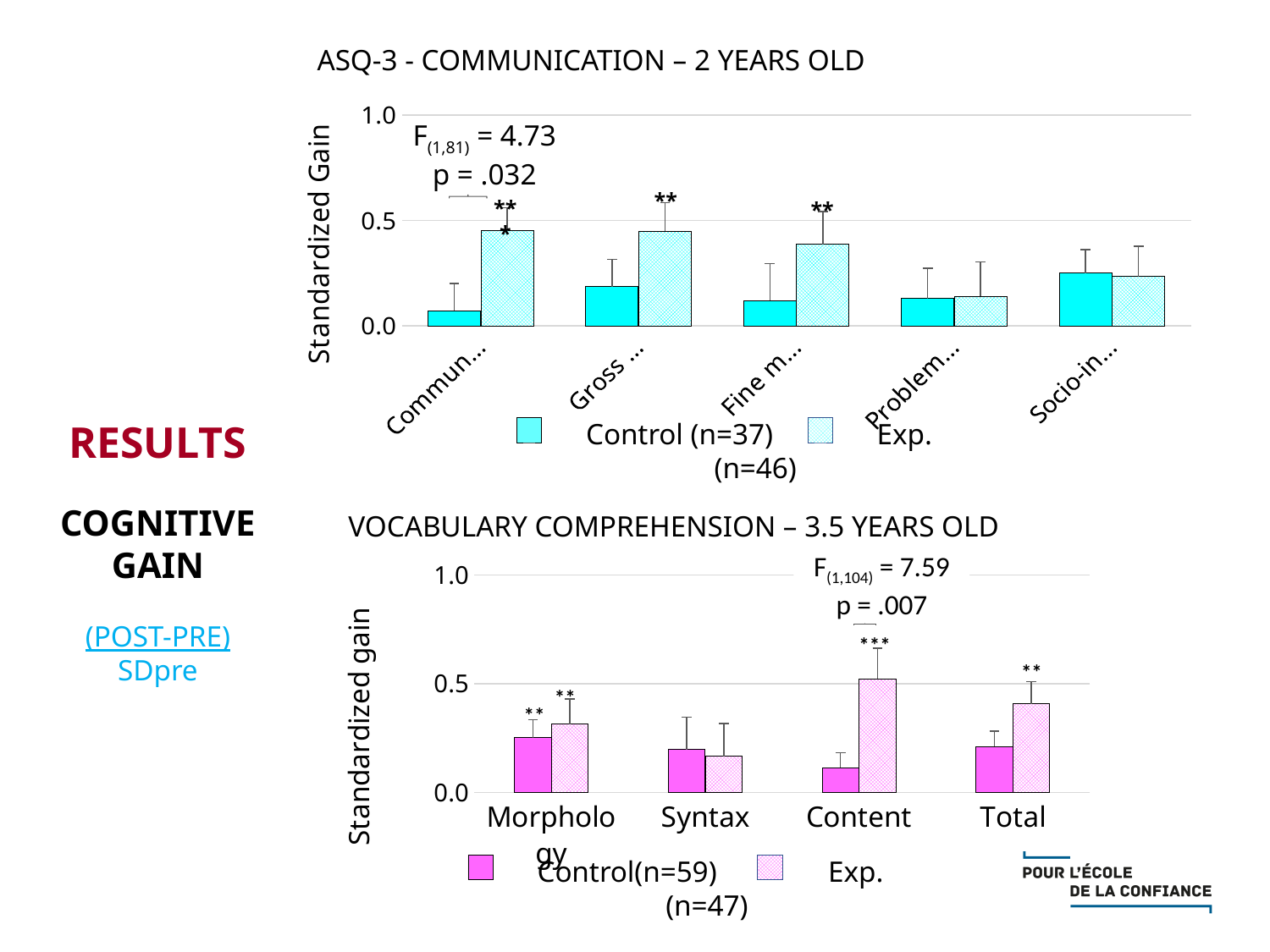
How many categories are shown on the x axis of the VOCABULARY COMPREHENSION – 3.5 YEARS OLD chart? 4 How many series does the legend of the VOCABULARY COMPREHENSION – 3.5 YEARS OLD chart list? 2 What are the two legend entries of the ASQ-3 - COMMUNICATION – 2 YEARS OLD chart? Control (n=37) and Exp. (n=46) In the VOCABULARY COMPREHENSION – 3.5 YEARS OLD chart, which category has the lowest Control(n=59) bar? Content In the ASQ-3 - COMMUNICATION – 2 YEARS OLD chart, for the first category (Commun...), which series has the larger value, Control (n=37) or Exp. (n=46)? Exp. (n=46) In the VOCABULARY COMPREHENSION – 3.5 YEARS OLD chart, is the Exp. (n=47) value for Total greater or less than 0.5? less In the ASQ-3 - COMMUNICATION – 2 YEARS OLD chart, is the Exp. (n=46) value for Fine m... greater or less than 0.5? less What kind of chart is the VOCABULARY COMPREHENSION – 3.5 YEARS OLD chart? bar chart In the VOCABULARY COMPREHENSION – 3.5 YEARS OLD chart, which category has the highest Exp. (n=47) bar? Content How many series does the legend of the ASQ-3 - COMMUNICATION – 2 YEARS OLD chart list? 2 In the VOCABULARY COMPREHENSION – 3.5 YEARS OLD chart, for Content, which series has the larger value, Control(n=59) or Exp. (n=47)? Exp. (n=47) How many categories are shown on the x axis of the ASQ-3 - COMMUNICATION – 2 YEARS OLD chart? 5